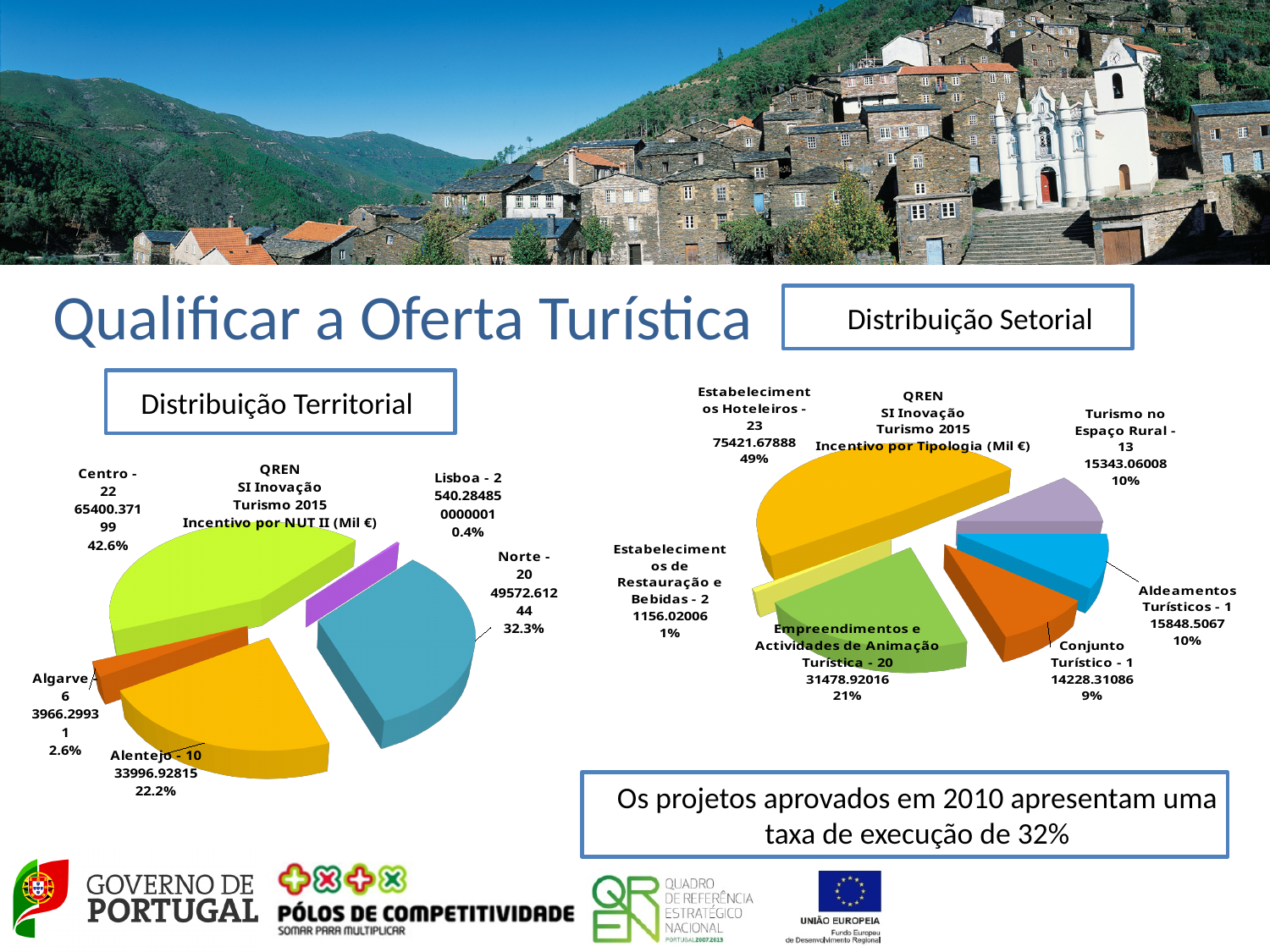
What type of chart is used for the 'Incentivo por Tipologia' data? Pie chart In the 'Incentivo por Tipologia' pie chart, which category has the smallest share? Estabelecimentos de Restauração e Bebidas In the 'Incentivo por Tipologia' pie chart, what is the value (Mil €) for Conjunto Turístico? 14228.31086 In the 'Incentivo por NUT II' pie chart, how many regions (slices) are shown? 5 In the 'Incentivo por NUT II' pie chart, which region has the largest share? Centro In the 'Incentivo por NUT II' pie chart, which region has the smallest share? Lisboa In the 'Incentivo por Tipologia' pie chart, how many categories (slices) are shown? 6 In the 'Incentivo por NUT II' pie chart, what percentage share does Centro have? 42.6% In the 'Incentivo por Tipologia' pie chart, which is larger: the share of Empreendimentos e Actividades de Animação Turística or the share of Turismo no Espaço Rural? Empreendimentos e Actividades de Animação Turística In the 'Incentivo por NUT II' pie chart, what is the percentage share for Norte? 32.3% In the 'Incentivo por Tipologia' pie chart, what percentage share do Estabelecimentos Hoteleiros have? 49% In the 'Incentivo por NUT II' pie chart, what is the difference in percentage points between Alentejo (22.2%) and Algarve (2.6%)? 19.6 percentage points